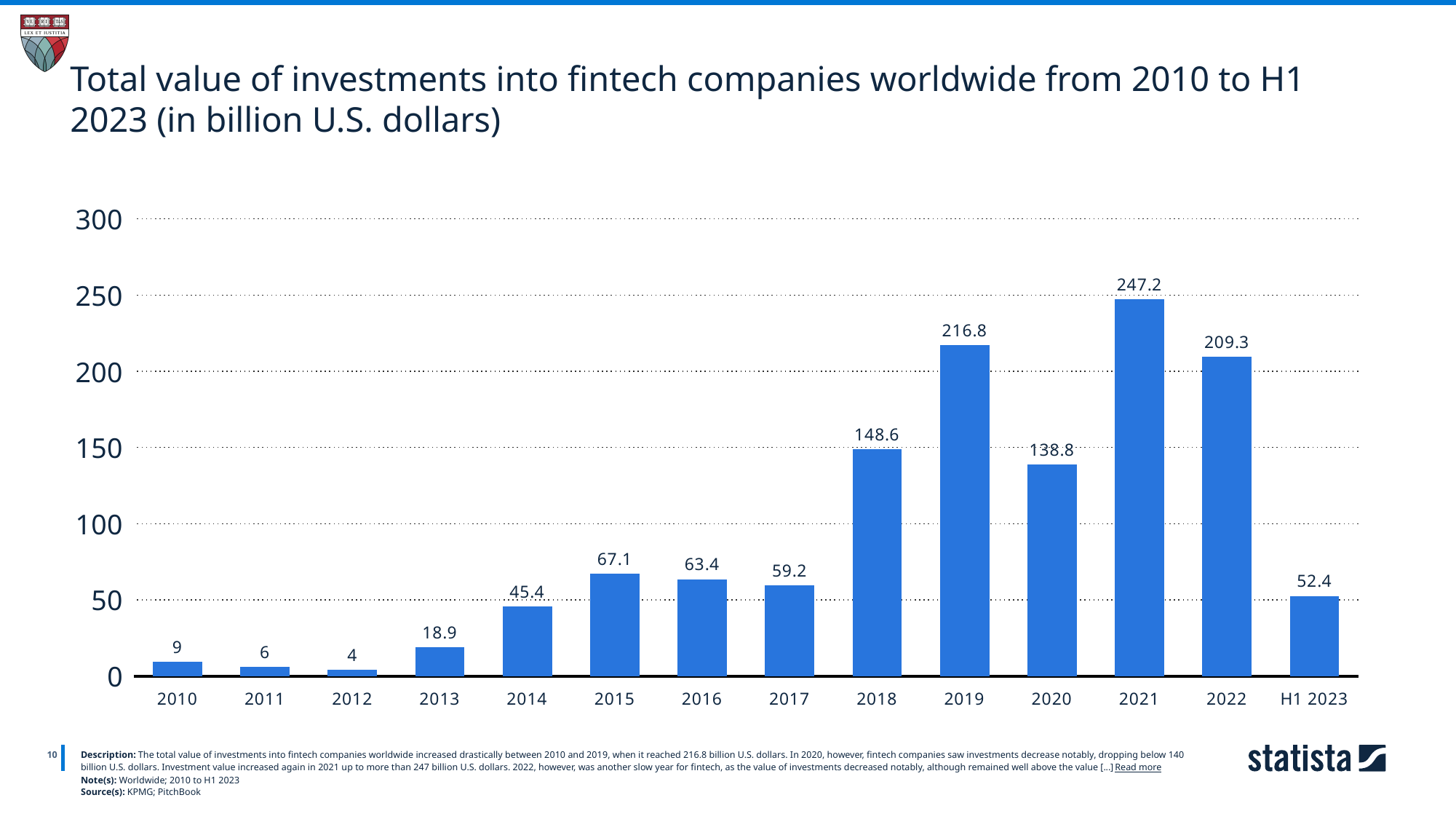
What is the value shown for H1 2023? 52.4 Which year has the highest value of fintech investments? 2021 What kind of chart is shown on the slide? bar chart Which year has the lowest value of fintech investments? 2012 Which is larger, the value for 2015 or the value for 2016? 2015 What is the difference between the values for 2019 and 2020? 78 Is the value for 2018 greater or less than 100? greater What is the total value of fintech investments in 2021? 247.2 How many years or periods are shown on the x axis? 14 What is the difference between the values for 2021 and 2022? 37.9 Do the values rise or fall from 2010 to 2019? rise What is the value shown for 2012? 4